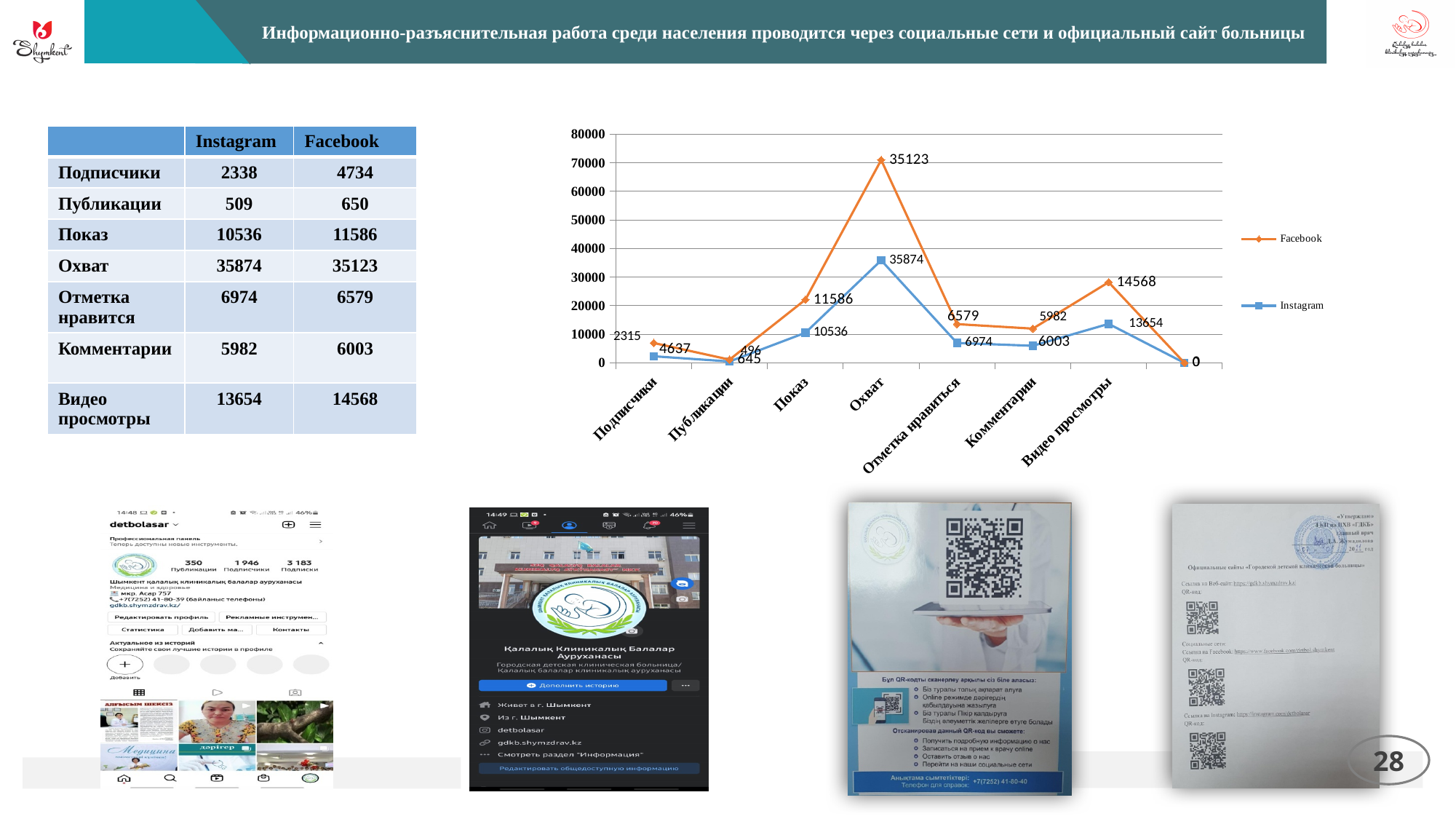
What is the data label for Facebook at Видео просмотры? 14568 What is the data label for Instagram at Отметка нравится? 6974 What is the data label for Instagram at Показ? 10536 What is the highest value shown on the chart's vertical axis? 80000 What is the difference between the Facebook and Instagram data labels at Показ? 1050 How many series does the chart legend list? 2 What is the data label for Instagram at Охват? 35874 What type of chart is shown on the slide? line chart What is the data label for Facebook at Показ? 11586 For which category does Instagram have its highest data label? Охват At Охват, which series has the larger data label, Facebook or Instagram? Instagram Which two series are listed in the chart legend? Facebook and Instagram